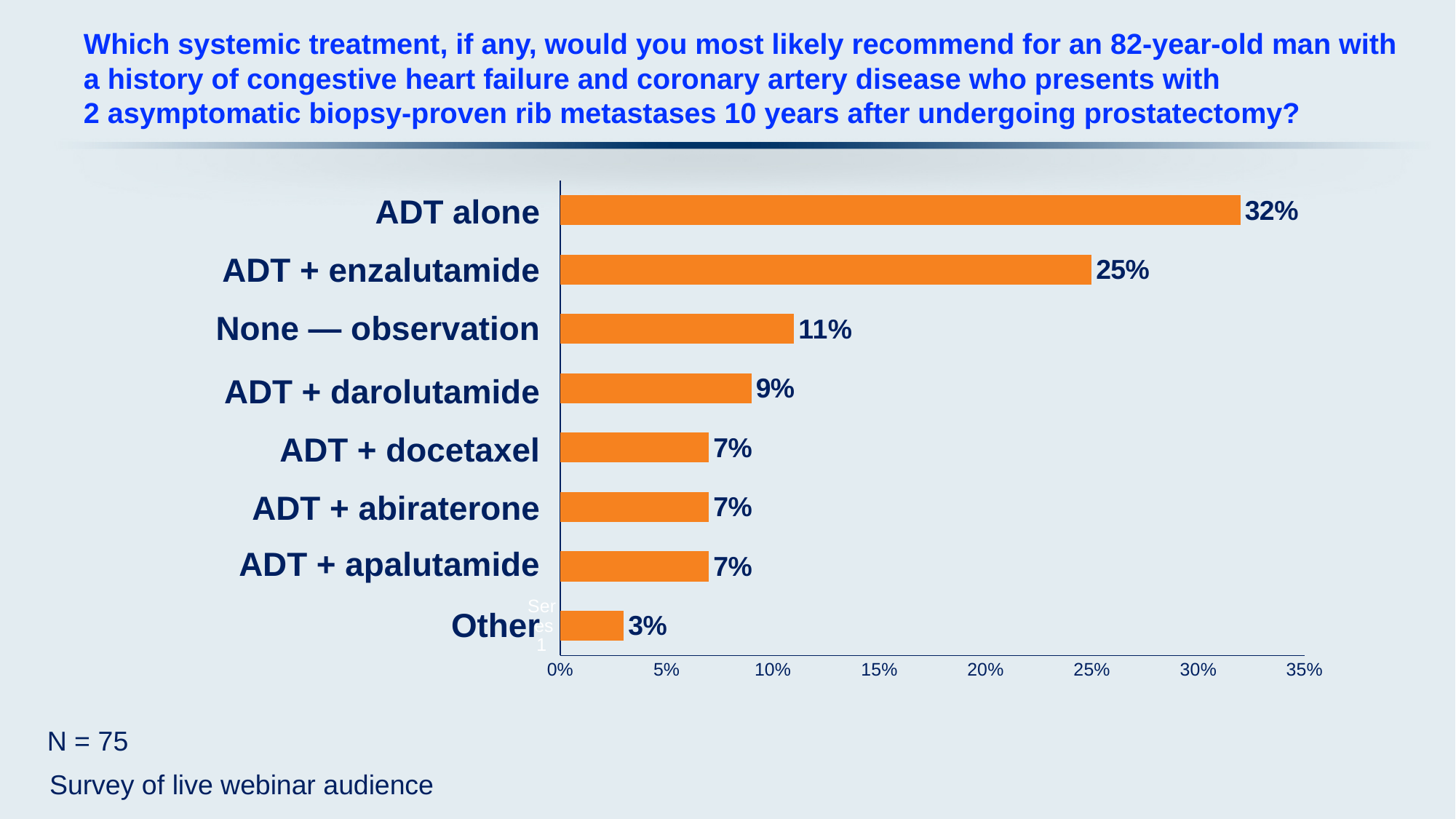
Which is larger, None — observation or ADT + darolutamide? None — observation Is the value for ADT alone greater or less than 30%? greater What is the value for ADT + enzalutamide? 25% What is the value for ADT + darolutamide? 9% Which treatment option received the highest percentage? ADT alone What is the sample size (N) stated on the slide? N = 75 What percentage of respondents chose ADT alone? 32% What percentage chose None — observation? 11% What type of chart is shown on the slide? Bar chart What is the difference between ADT alone and ADT + enzalutamide? 7% Which category has the lowest value? Other How many treatment categories are shown in the chart? 8